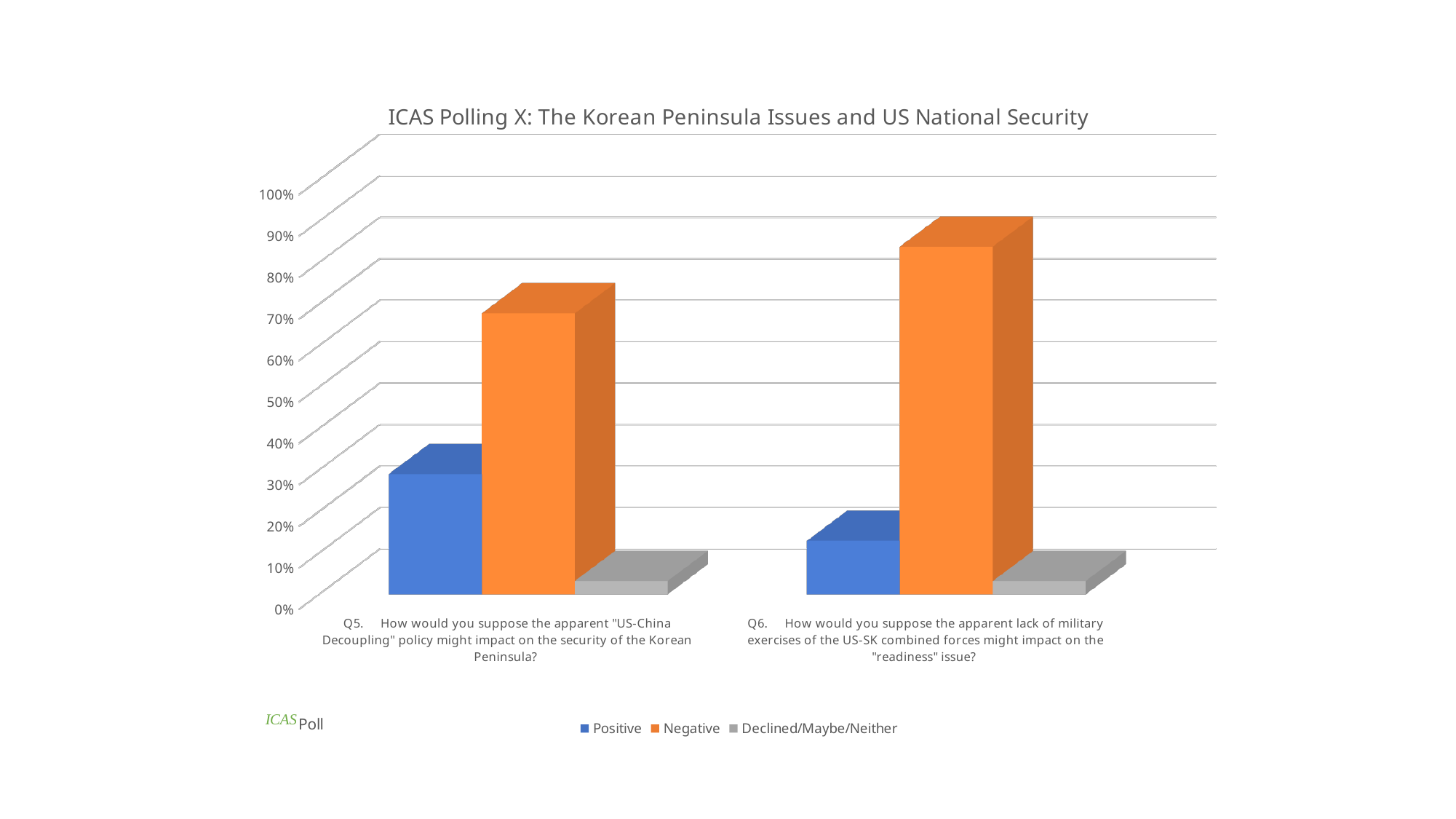
How many question categories are shown on the x axis? 2 Which response series has the lowest value for Q6? Declined/Maybe/Neither What kind of chart is shown on the slide? bar chart Is the Positive value larger for Q5 or for Q6? Q5 Is the Declined/Maybe/Neither value for Q6 greater or less than 10%? less Which response series has the highest value for Q5? Negative How many series does the legend list? 3 Is the Negative value larger for Q5 or for Q6? Q6 Is the Positive value for Q5 greater or less than 40%? less What is the title of the chart? ICAS Polling X: The Korean Peninsula Issues and US National Security Is the Negative value for Q5 greater or less than 60%? greater